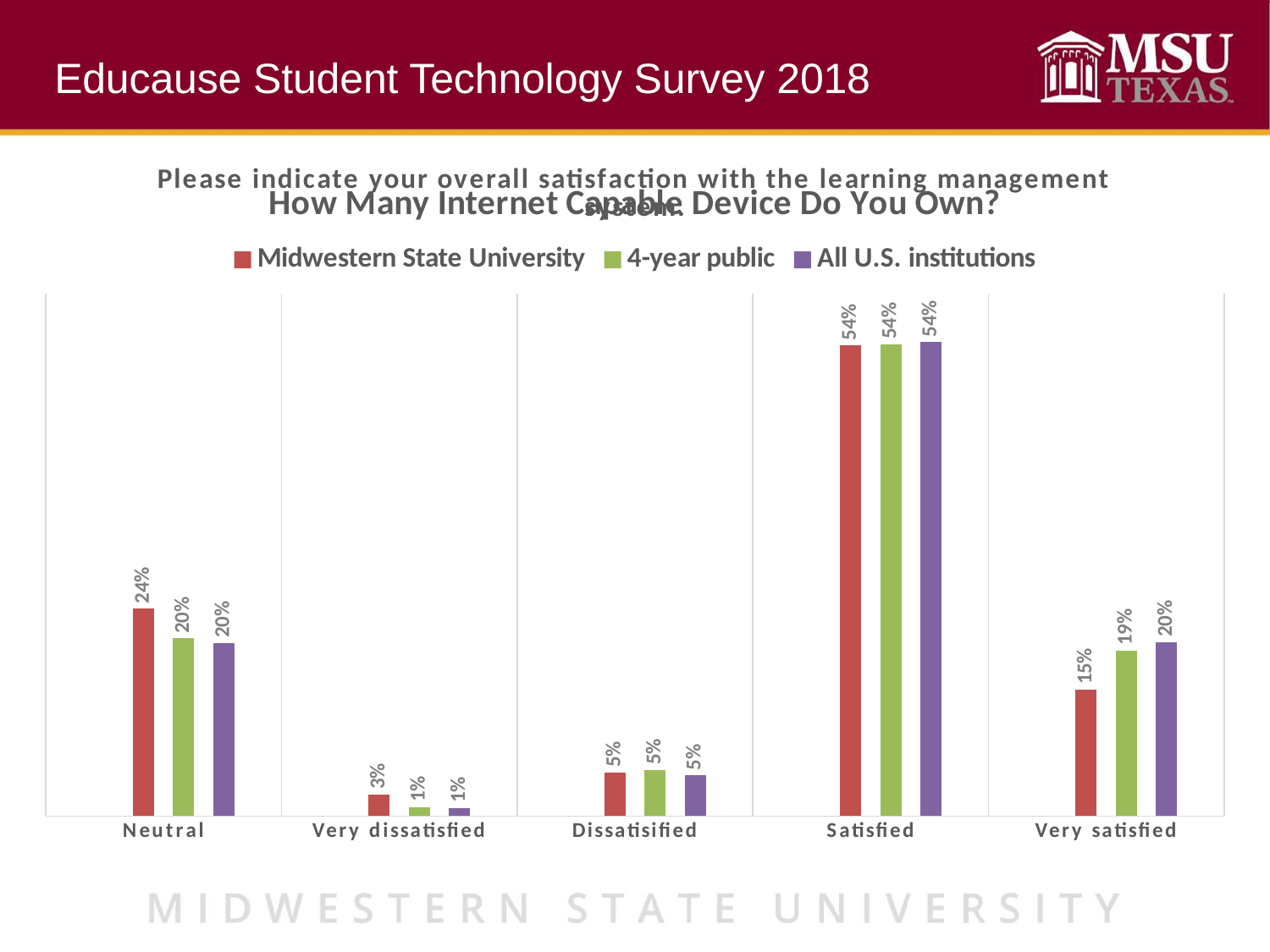
What is the value for 4-year public in the Very satisfied category? 19% What is the value for Midwestern State University in the Neutral category? 24% How many categories are shown on the x axis? 5 Which category has the lowest value for 4-year public? Very dissatisfied How many series does the legend list? 3 What kind of chart is shown on the slide? Bar chart What is the value for Midwestern State University in the Satisfied category? 54% Which category has the highest value for Midwestern State University? Satisfied In the Neutral category, which is larger: Midwestern State University or 4-year public? Midwestern State University What is the value for All U.S. institutions in the Very dissatisfied category? 1% Which series is shown in purple in the legend? All U.S. institutions What is the difference between the Midwestern State University and All U.S. institutions values in the Very satisfied category? 5%